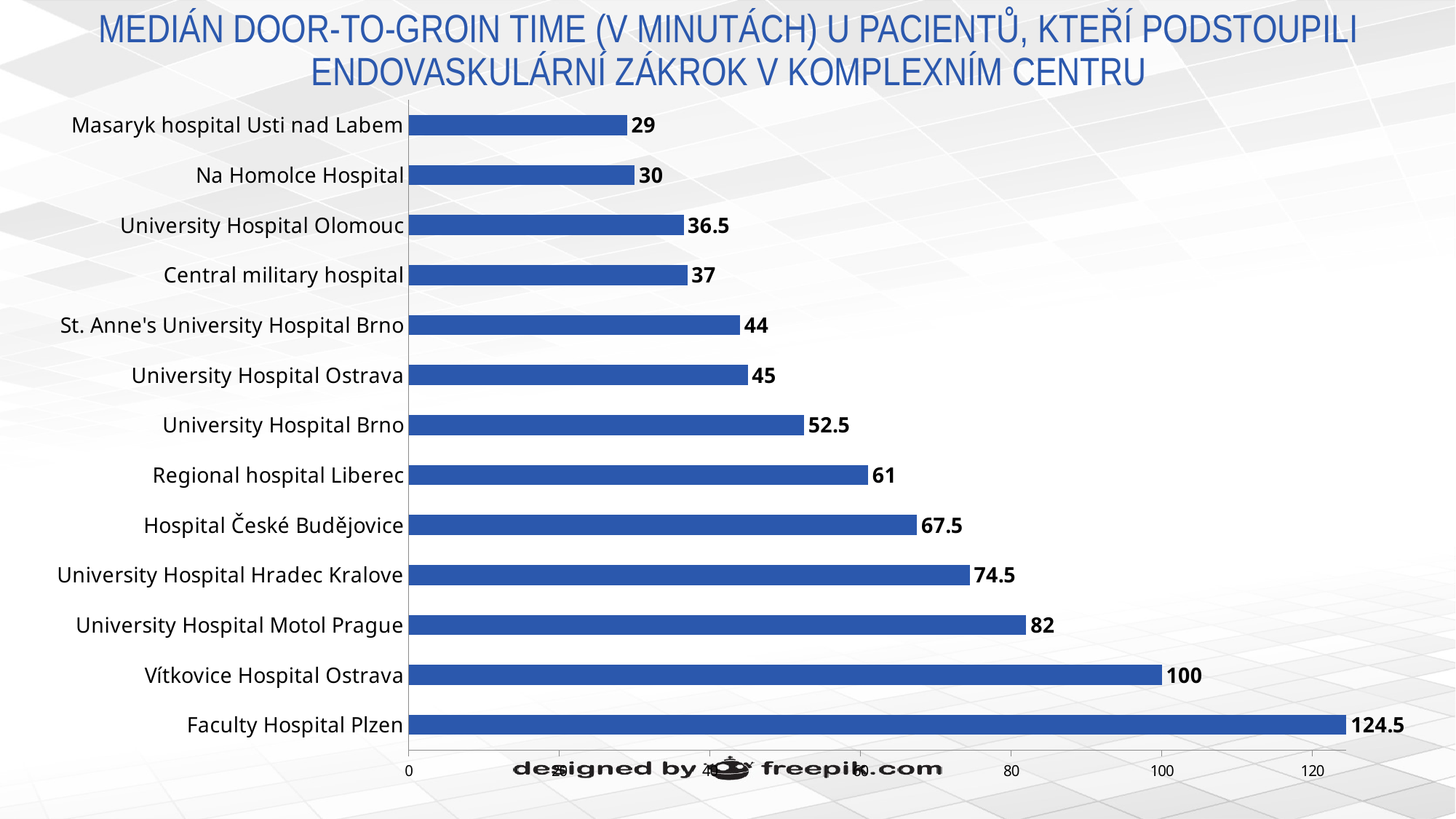
What is the difference between the median door-to-groin time of Faculty Hospital Plzen and Vítkovice Hospital Ostrava? 24.5 How many hospitals are shown in the chart? 13 Is the value for Hospital České Budějovice greater or less than 60? greater What is the difference between the median door-to-groin time of University Hospital Motol Prague and University Hospital Hradec Kralove? 7.5 What is the median door-to-groin time for Central military hospital? 37 What kind of chart is shown on the slide? bar chart Which hospital has the highest median door-to-groin time? Faculty Hospital Plzen What is the median door-to-groin time for Vítkovice Hospital Ostrava? 100 Which hospital has the lowest median door-to-groin time? Masaryk hospital Usti nad Labem What is the median door-to-groin time for Regional hospital Liberec? 61 Which has a higher median door-to-groin time, University Hospital Brno or St. Anne's University Hospital Brno? University Hospital Brno What is the median door-to-groin time for University Hospital Olomouc? 36.5